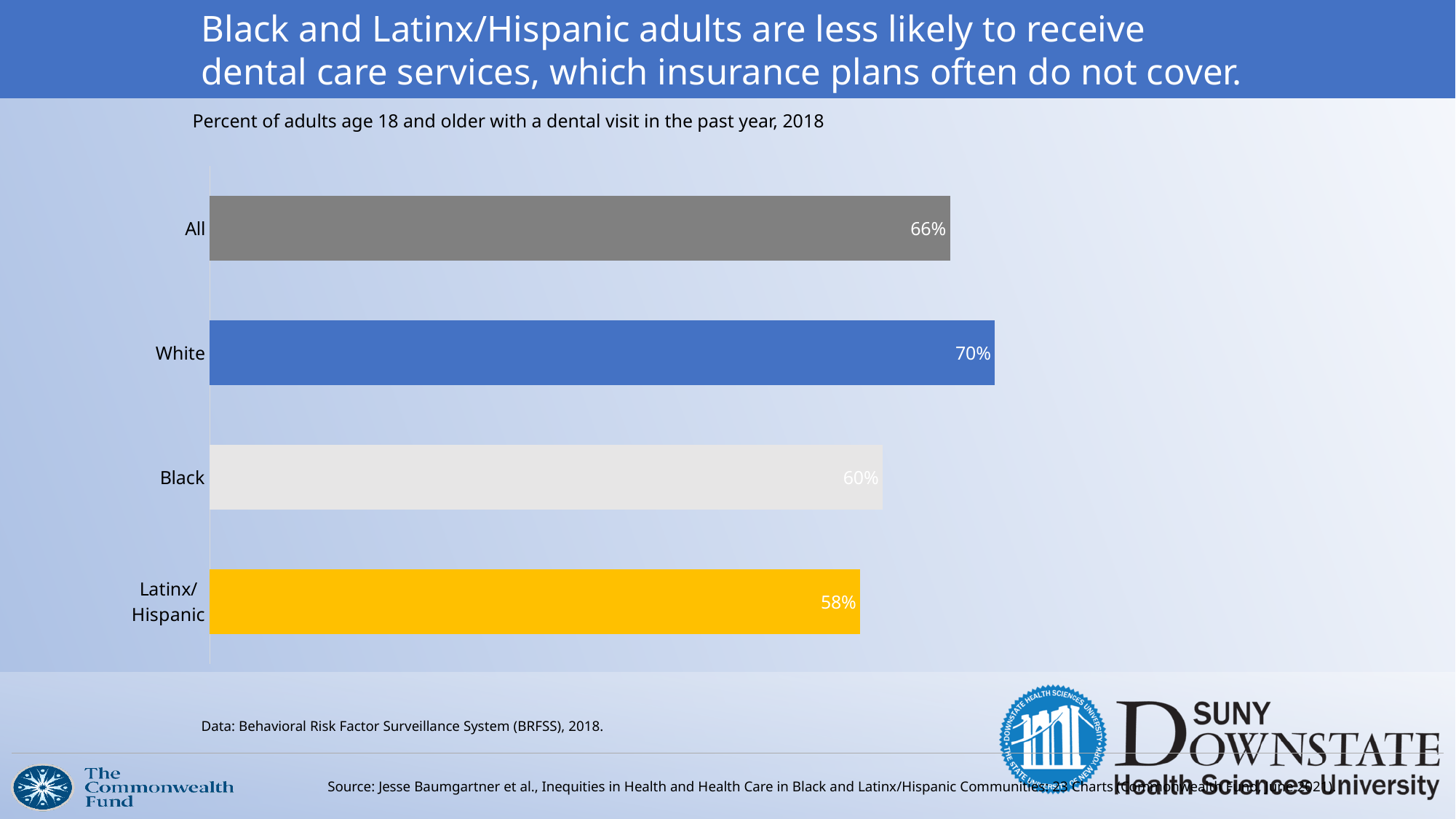
What is the value for Black adults? 60% Which group has the lowest percent of adults with a dental visit in the past year? Latinx/Hispanic Which is larger, the value for All adults or the value for Black adults? All What is the value for White adults? 70% What percent of all adults age 18 and older had a dental visit in the past year? 66% What year does the chart's data refer to? 2018 What is the difference in percentage points between White and Latinx/Hispanic adults? 12 Which group has the highest percent of adults with a dental visit in the past year? White What is the difference in percentage points between White and Black adults? 10 What kind of chart is shown on the slide? Bar chart How many groups are shown in the chart? 4 What is the value for Latinx/Hispanic adults? 58%